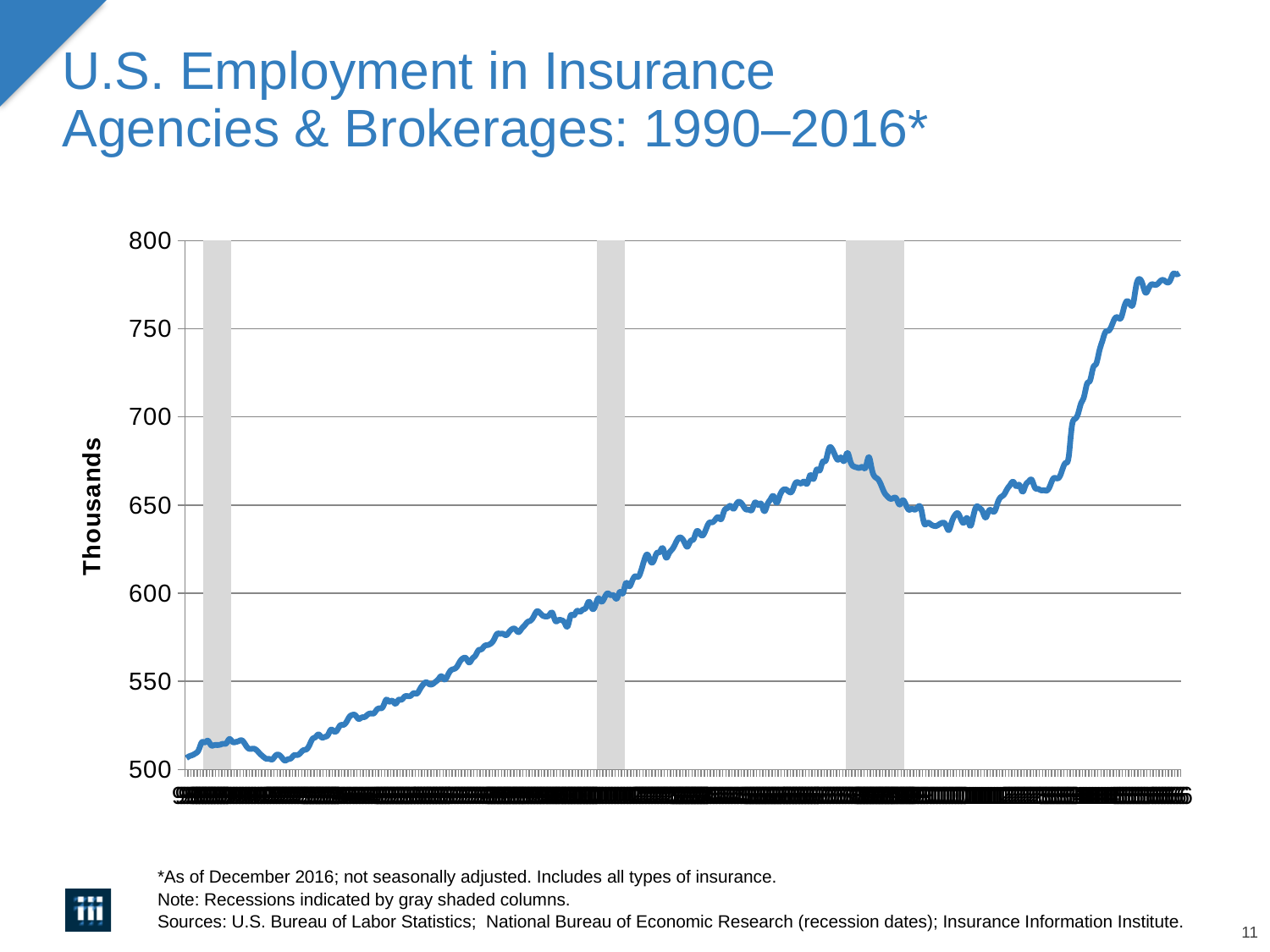
Where along the x axis does the line reach its highest value: near the left end or near the right end? near the right end Is the low point the line reaches after the third gray shaded column greater or less than 600? greater Is the value at the right end of the line larger or smaller than the value at the left end? larger Is the lowest value of the line greater or less than 550? less Is the highest value reached by the line greater or less than 750? greater How many gray shaded recession columns are shown on the chart? 3 What kind of chart is shown on the slide? line chart Overall, does the line rise or fall from the left end of the x axis to the right end? rise What is the title of the vertical axis? Thousands